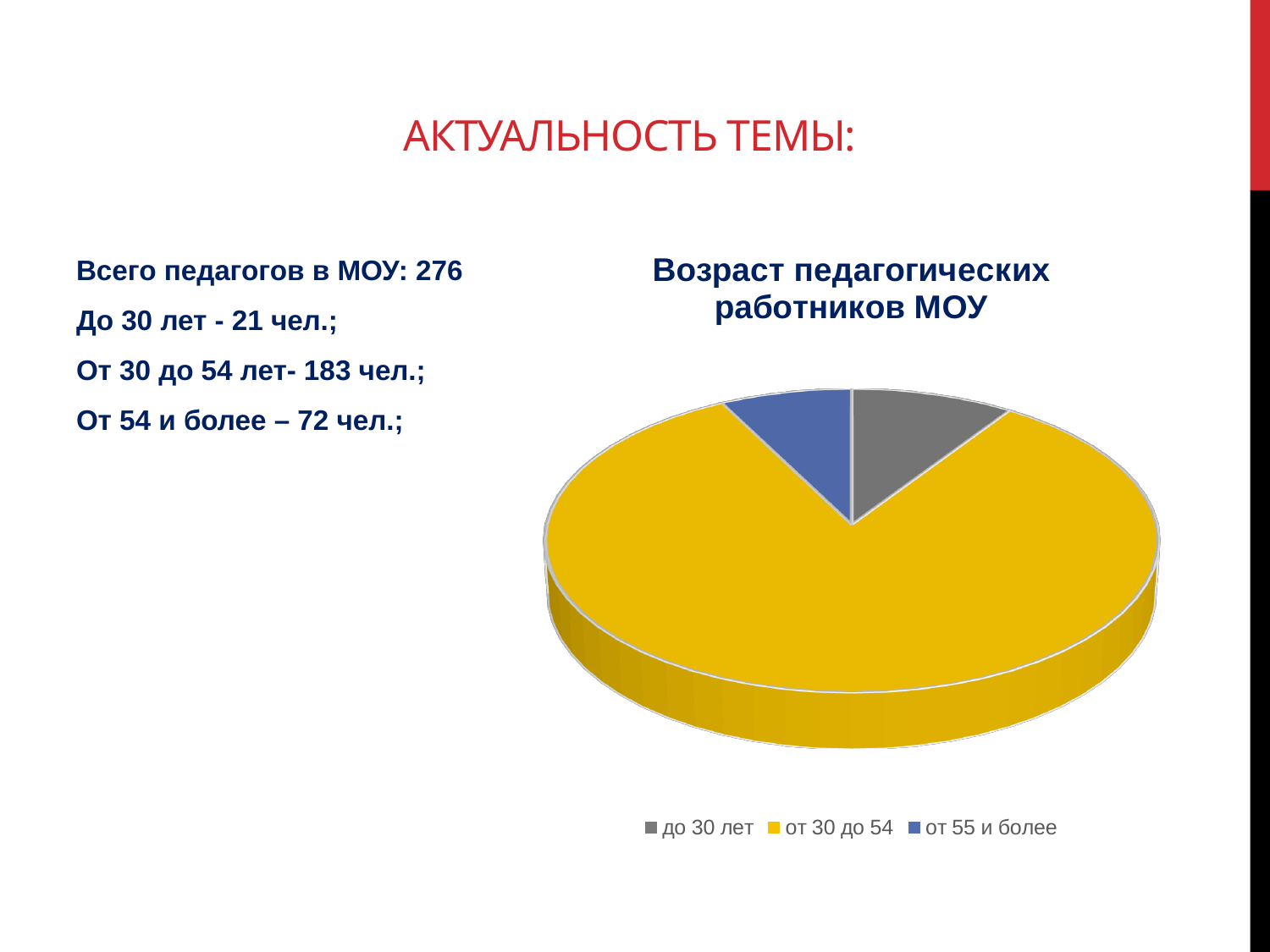
Which category has the largest slice of the pie? от 30 до 54 How many slices does the pie chart have? 3 Which legend entry is shown in blue? от 55 и более How many entries does the chart legend list? 3 Which slice is larger: "от 55 и более" or "от 30 до 54"? от 30 до 54 What kind of chart is shown on the slide? pie chart What is the title of the chart? Возраст педагогических работников МОУ Does the slice for "от 30 до 54" take up more or less than half of the pie? more Which slice is larger: "до 30 лет" or "от 30 до 54"? от 30 до 54